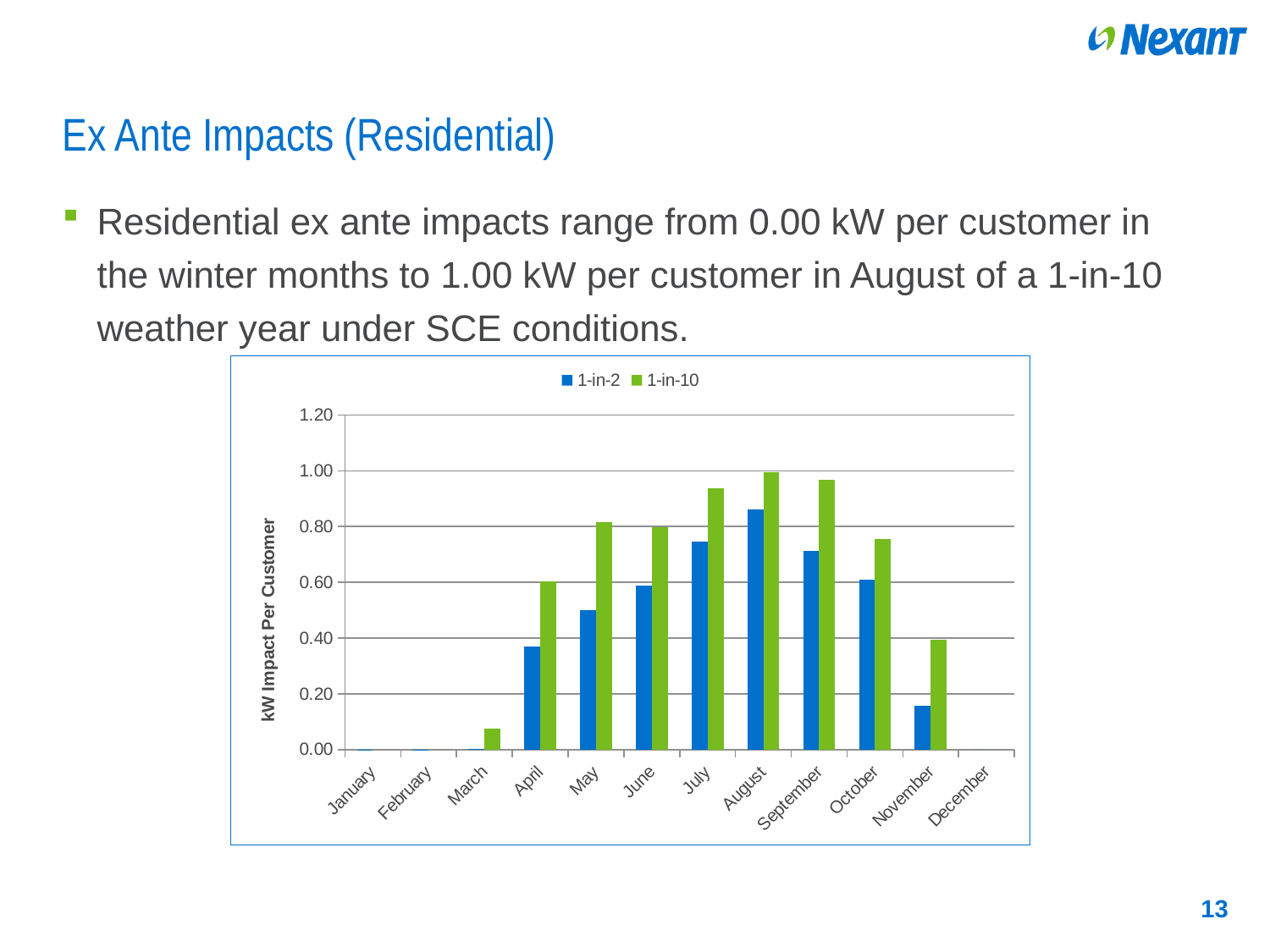
Is the 1-in-2 value for May greater or less than 0.60? less Do the 1-in-2 values rise or fall from April to August? rise Which month has the highest 1-in-10 value? August How many series does the chart's legend list? 2 Is the 1-in-2 value for August greater or less than 0.80? greater How many months are shown along the x axis of the chart? 12 Which month has the highest 1-in-2 value? August Which is larger in July, the 1-in-2 value or the 1-in-10 value? 1-in-10 Which is larger, the 1-in-2 value for October or the 1-in-2 value for November? October What is the label on the chart's vertical axis? kW Impact Per Customer Is the 1-in-10 value for November greater or less than 0.60? less What kind of chart is shown on the slide? bar chart